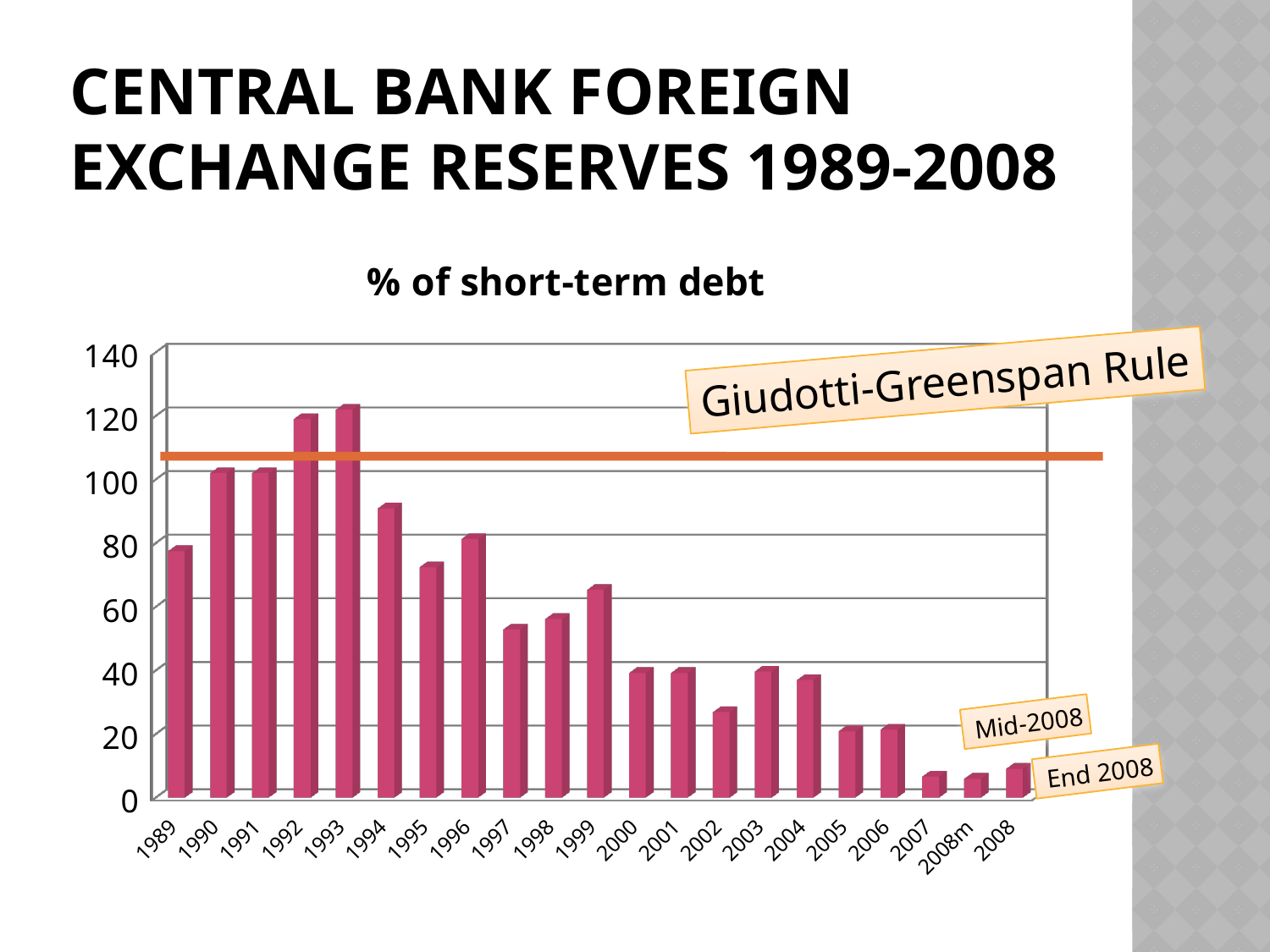
Do the values generally rise or fall from 1993 to 2008? fall What kind of chart is shown on the slide? bar chart Is the value for 1989 greater or less than 60? greater What is the title shown above the chart? % of short-term debt Is the value for 2005 greater or less than 40? less Is the value for 1992 greater or less than 100? greater Which is larger, the value for 1990 or the value for 1994? 1990 Which is larger, the value for 2003 or the value for 2005? 2003 How many bars (categories) are plotted on the x axis? 21 What label is attached to the horizontal orange line on the chart? Giudotti-Greenspan Rule